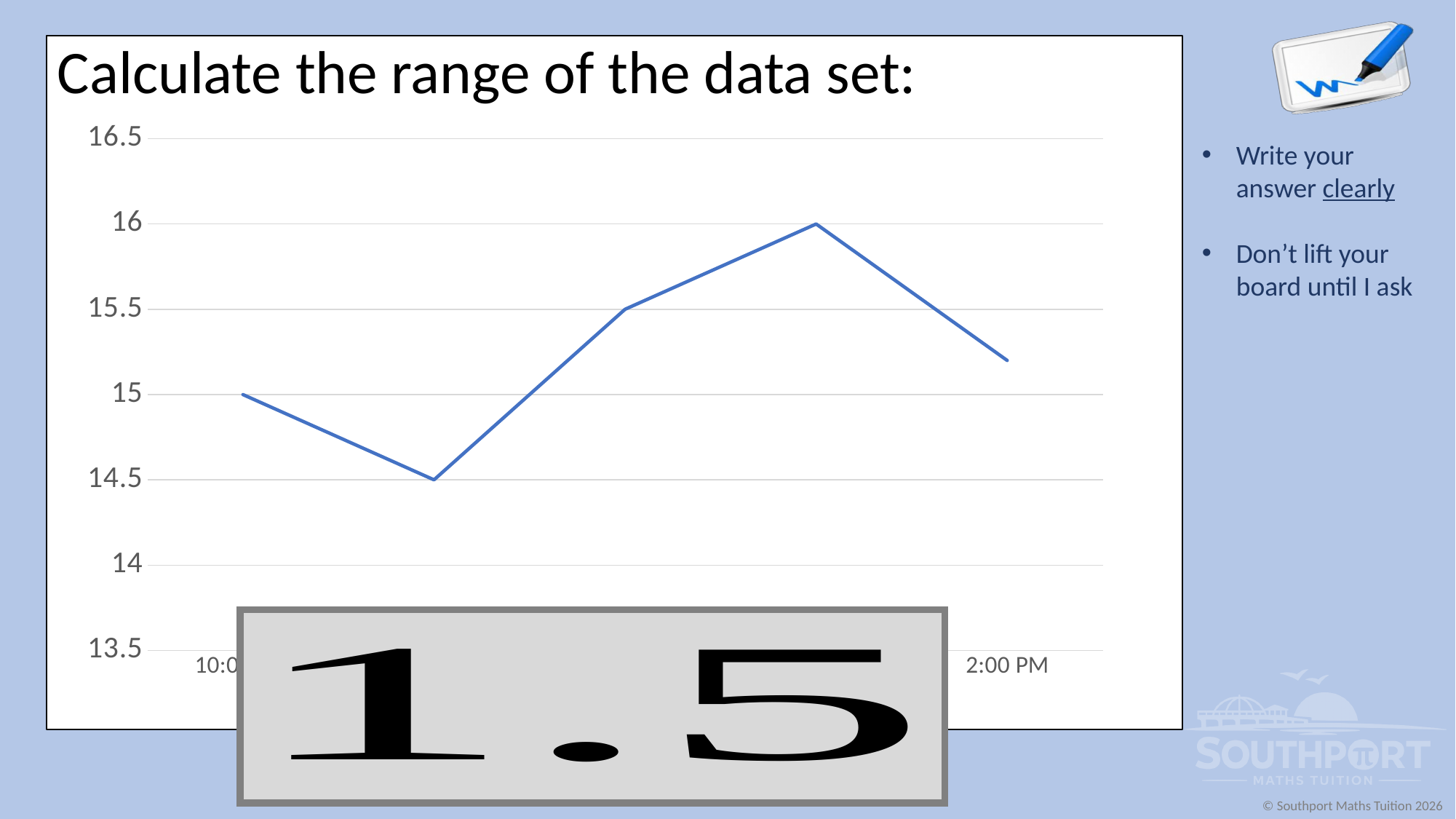
What is the difference between the highest and lowest values plotted on the line chart? 1.5 How many data points are plotted on the line chart? 5 What is the title shown above the chart? Calculate the range of the data set: What is the value of the first plotted point on the line chart? 15 Which is larger, the first plotted point or the second plotted point? the first plotted point What is the value of the third plotted point on the line chart? 15.5 Is the value at 2:00 PM greater or less than 15.5? less What is the value of the second plotted point on the line chart? 14.5 What kind of chart is shown on the slide? line chart What is the highest value plotted on the line chart? 16 Is the value at 2:00 PM greater or less than 15? greater What is the lowest value plotted on the line chart? 14.5